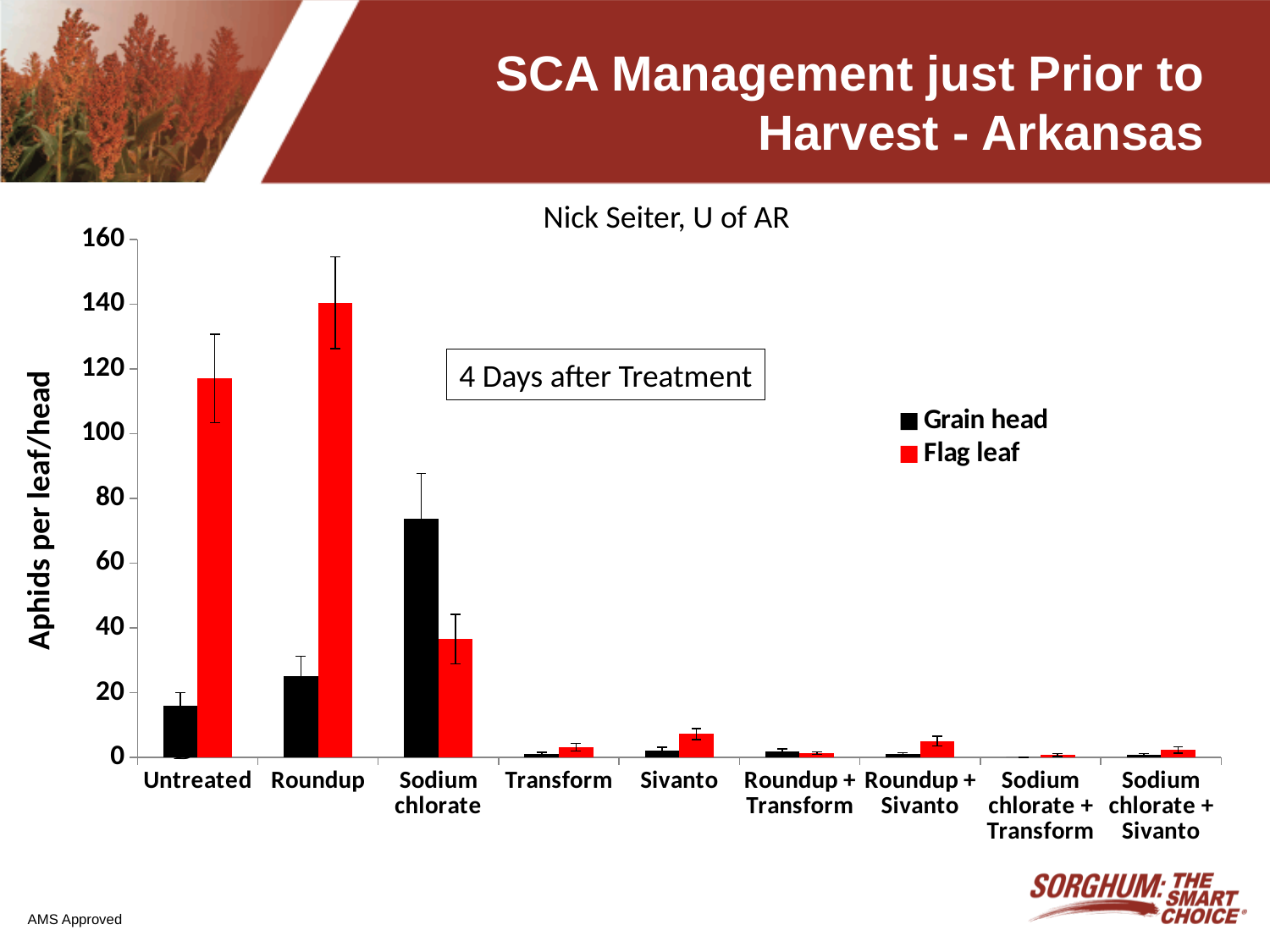
Which treatment has the highest Grain head value? Sodium chlorate How many series does the legend list? 2 How many treatment categories are shown on the x axis? 9 For Sodium chlorate, which is larger: the Grain head value or the Flag leaf value? Grain head Is the Flag leaf value for Untreated greater or less than 100? greater What is the label on the y axis of the chart? Aphids per leaf/head Is the Grain head value for Sodium chlorate greater or less than 60? greater What kind of chart is shown on the slide? Bar chart Which is larger: the Flag leaf value for Roundup or the Flag leaf value for Untreated? Roundup Which treatment has the highest Flag leaf value? Roundup Is the Grain head value for Untreated greater or less than 20? less